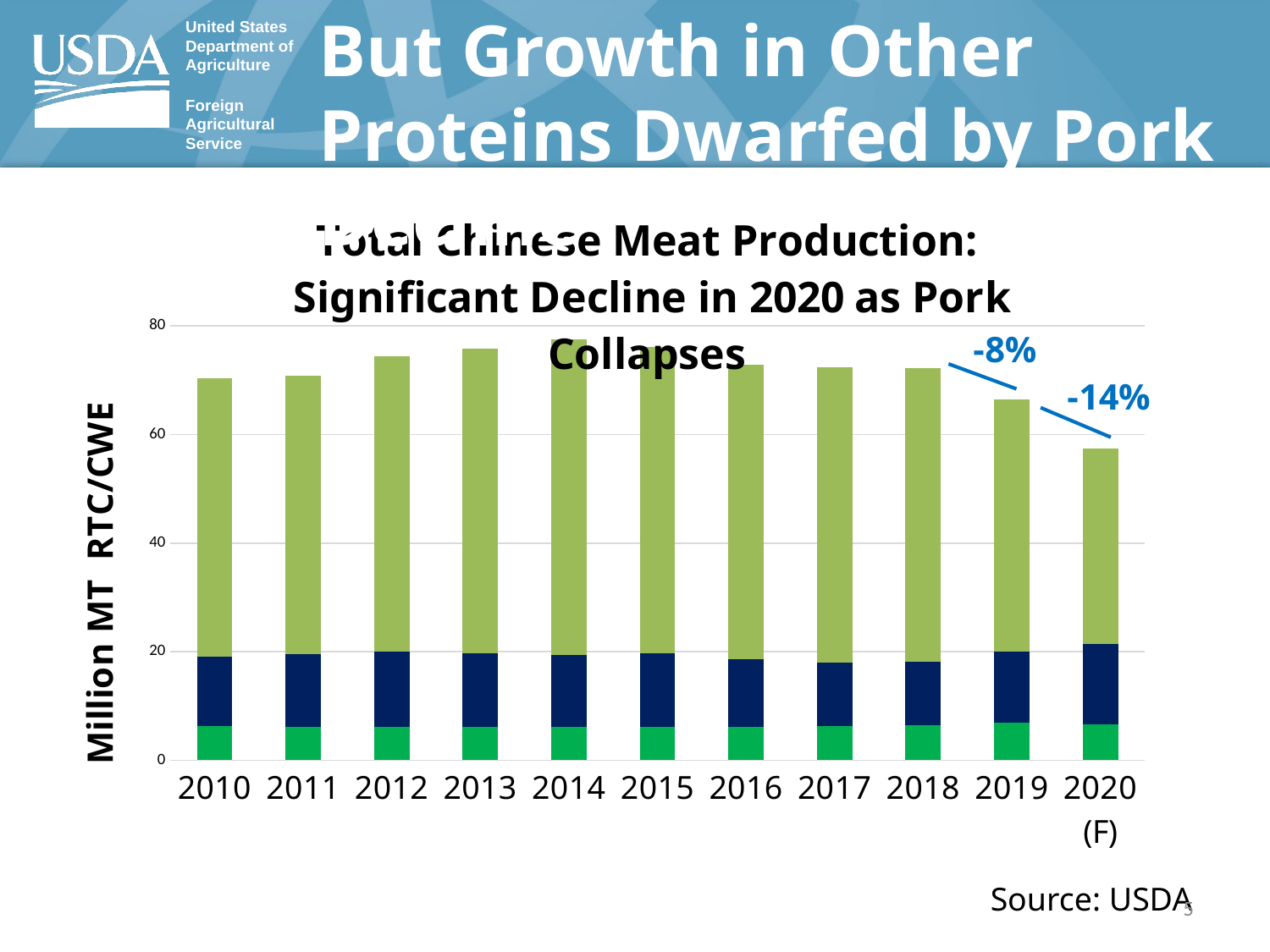
Which year has the lowest total Chinese meat production in the chart? 2020 (F) What percentage change is annotated between 2019 and 2020 (F) on the chart? -14% How many years are shown on the x axis of the chart? 11 What is the label on the y axis of the chart? Million MT RTC/CWE Which year has the larger total, 2010 or 2020 (F)? 2010 Which year has the larger total, 2019 or 2020 (F)? 2019 Is the total value for 2019 greater or less than 60? greater Is the total value for 2014 greater or less than 60? greater What kind of chart is shown on the slide? Stacked bar chart Is the total value for 2010 greater or less than 80? less Do the total values rise or fall from 2018 to 2020 (F)? fall